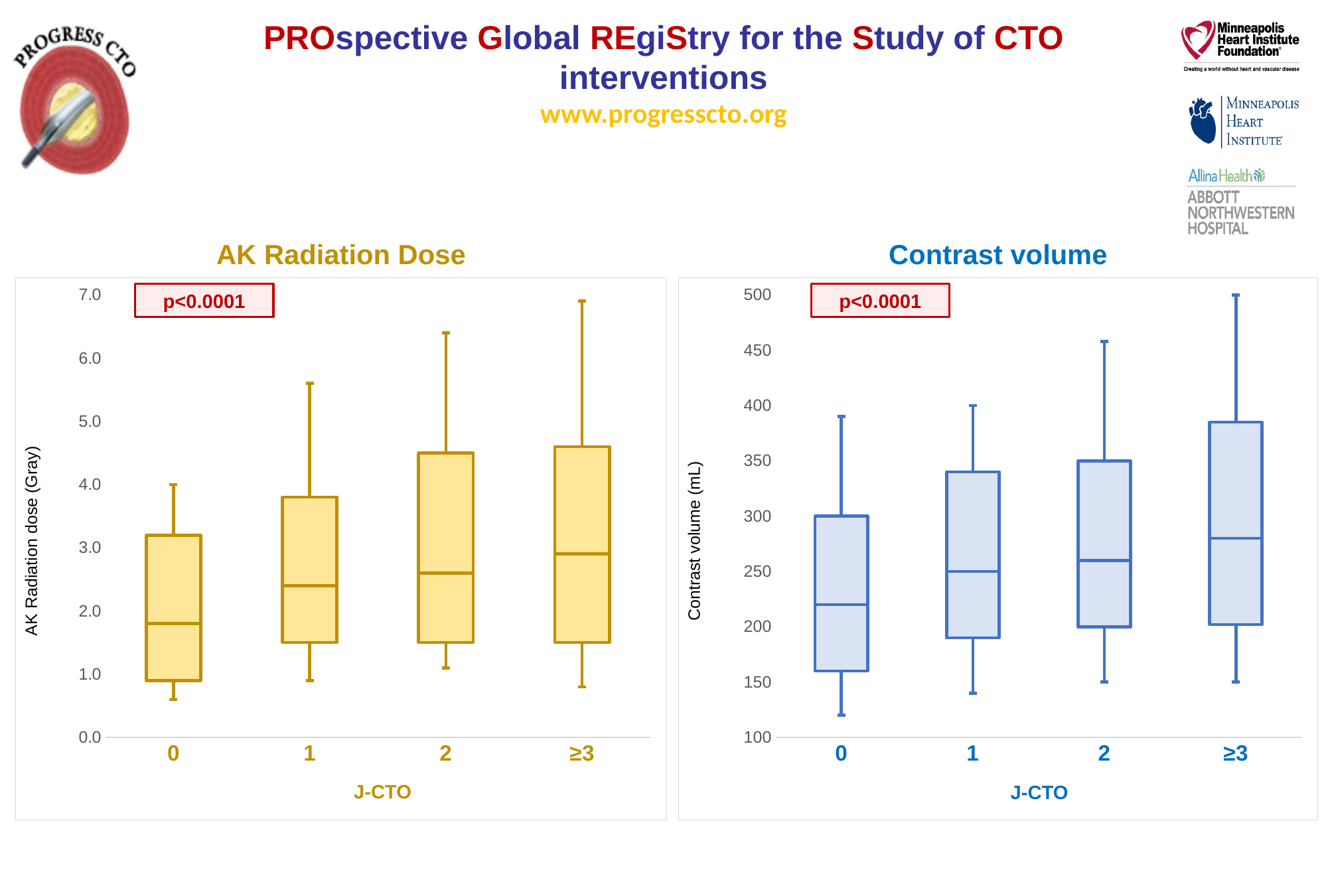
On the AK Radiation Dose chart, do the median values rise or fall as J-CTO increases from 0 to ≥3? Rise On the Contrast volume chart, which J-CTO category has the lowest median? 0 On the AK Radiation Dose chart, which J-CTO category has the highest median? ≥3 What p-value is shown on the Contrast volume chart? p<0.0001 How many J-CTO categories are shown on the Contrast volume chart? 4 On the Contrast volume chart, do the median values rise or fall as J-CTO increases from 0 to ≥3? Rise What kind of chart is the AK Radiation Dose chart? Box plot On the AK Radiation Dose chart, is the upper whisker for J-CTO ≥3 greater or less than 6.0? greater On the AK Radiation Dose chart, is the median for J-CTO 0 greater or less than 2.0? less On the AK Radiation Dose chart, which has the higher upper whisker, J-CTO 1 or J-CTO 2? J-CTO 2 On the Contrast volume chart, what is the value of the upper whisker for J-CTO ≥3? 500 On the Contrast volume chart, is the median for J-CTO 0 greater or less than 250? less